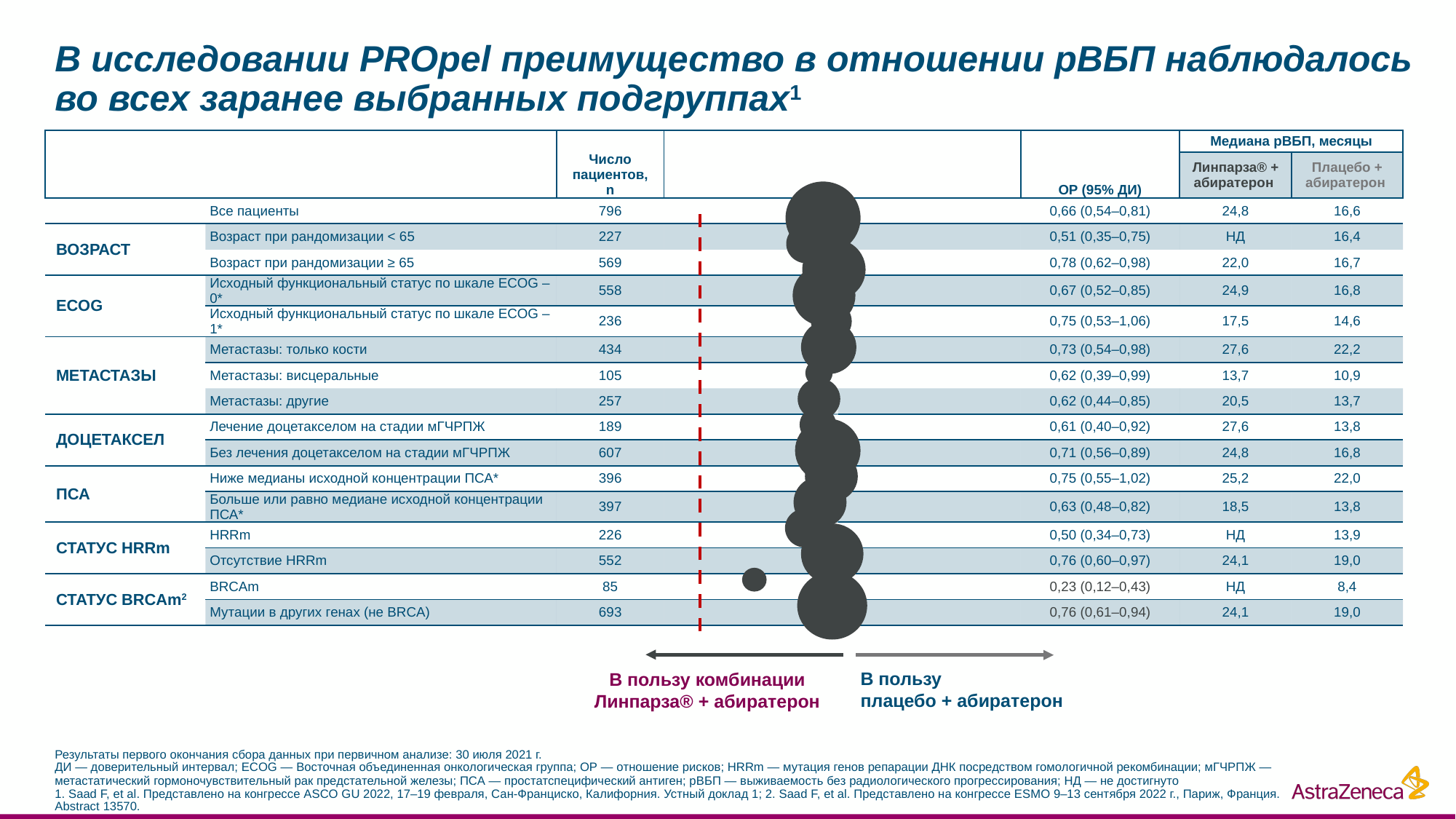
What is the difference in median rPFS (months) between Линпарза + абиратерон and Плацебо + абиратерон for all patients? 8,2 According to the arrow label below the plot, which treatment is favoured by points to the left of the dashed line? Комбинация Линпарза® + абиратерон What is the difference in number of patients between the Отсутствие HRRm and HRRm subgroups? 326 Which subgroup has the highest hazard ratio (ОР)? Возраст при рандомизации ≥ 65 Which subgroup has the higher median rPFS with Линпарза + абиратерон: Метастазы: только кости or Метастазы: висцеральные? Метастазы: только кости How many patients (n) are in the subgroup without docetaxel treatment at the mHSPC stage (Без лечения доцетакселом на стадии мГЧРПЖ)? 607 How many rows (subgroups including all patients) are plotted in the forest plot? 16 Which subgroup has the lowest hazard ratio (ОР)? BRCAm What is the median rPFS for Плацебо + абиратерон in the HRRm subgroup? 13,9 What is the hazard ratio (95% CI) for the visceral metastases subgroup (Метастазы: висцеральные)? 0,62 (0,39–0,99) What is the hazard ratio (95% CI) shown for all patients (Все пациенты)? 0,66 (0,54–0,81) How many patients (n) are in the BRCAm subgroup? 85